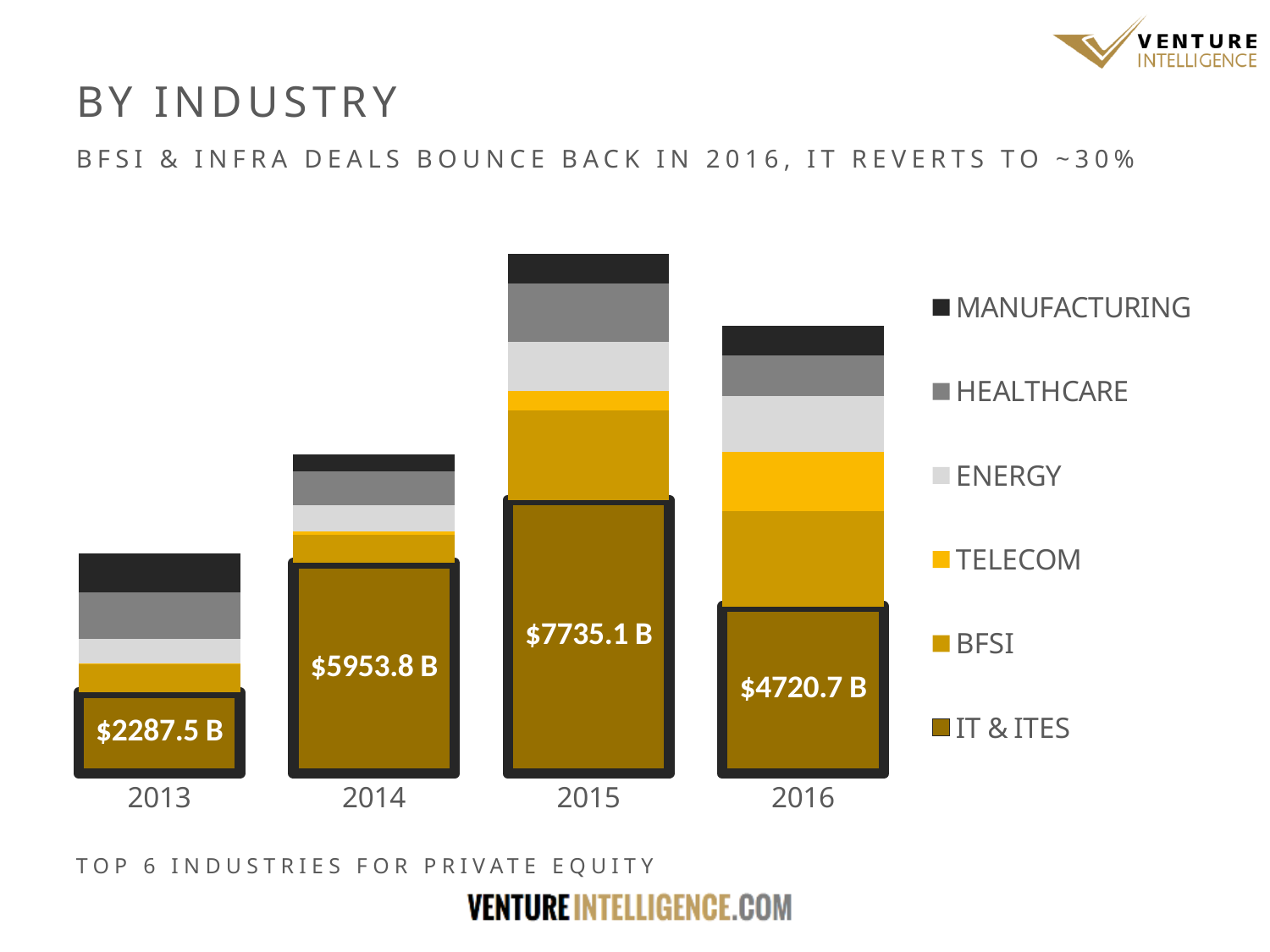
What is the value labelled for IT & ITES in 2015? $7735.1 B In which year is the labelled IT & ITES value the lowest? 2013 What is the difference between the IT & ITES values for 2015 and 2016? $3014.4 B How many years are shown on the x axis? 4 In which year is the labelled IT & ITES value the highest? 2015 What is the value labelled for IT & ITES in 2014? $5953.8 B What is the value labelled for IT & ITES in 2013? $2287.5 B What kind of chart is shown on the slide? Stacked bar chart What is the value labelled for IT & ITES in 2016? $4720.7 B Which series is shown at the bottom of each stacked bar? IT & ITES How many series does the legend list? 6 Which year has the larger IT & ITES value, 2014 or 2016? 2014